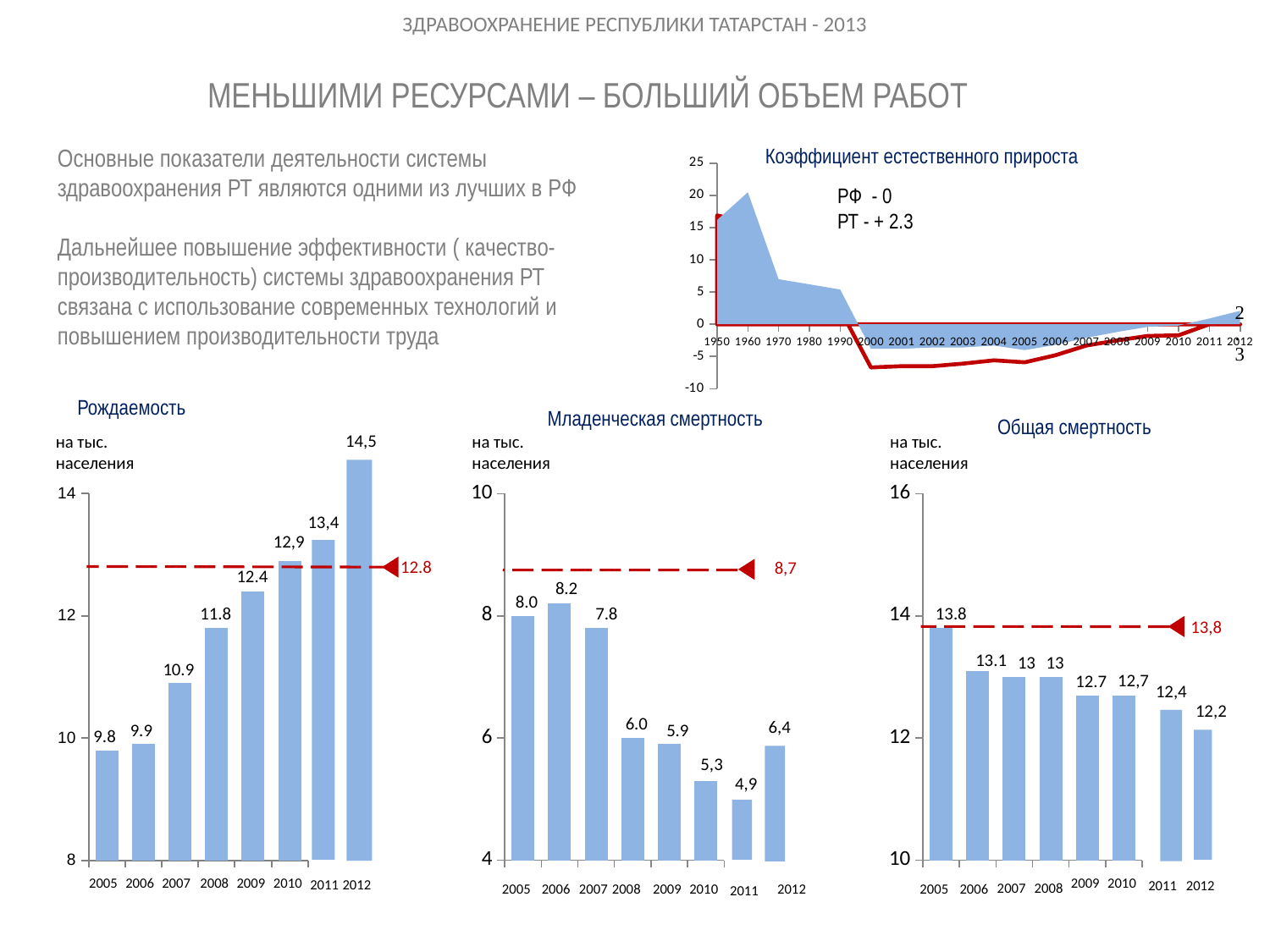
On the Младенческая смертность chart, what is the value for 2011? 4,9 On the Младенческая смертность chart, what value is marked by the red dashed line? 8,7 On the Рождаемость chart, what is the value for 2012? 14,5 On the Общая смертность chart, which year has the lowest value? 2012 On the Рождаемость chart, what is the difference between the values for 2008 and 2005? 2.0 On the Рождаемость chart, do the values rise or fall from 2005 to 2012? rise On the Общая смертность chart, what is the value for 2006? 13.1 How many years are shown on the Общая смертность chart? 8 On the Рождаемость chart, which year has the lowest value? 2005 On the Младенческая смертность chart, which year has the highest value? 2006 On the Младенческая смертность chart, which is larger, the value for 2008 or the value for 2012? 2012 What kind of chart is the Общая смертность chart? bar chart